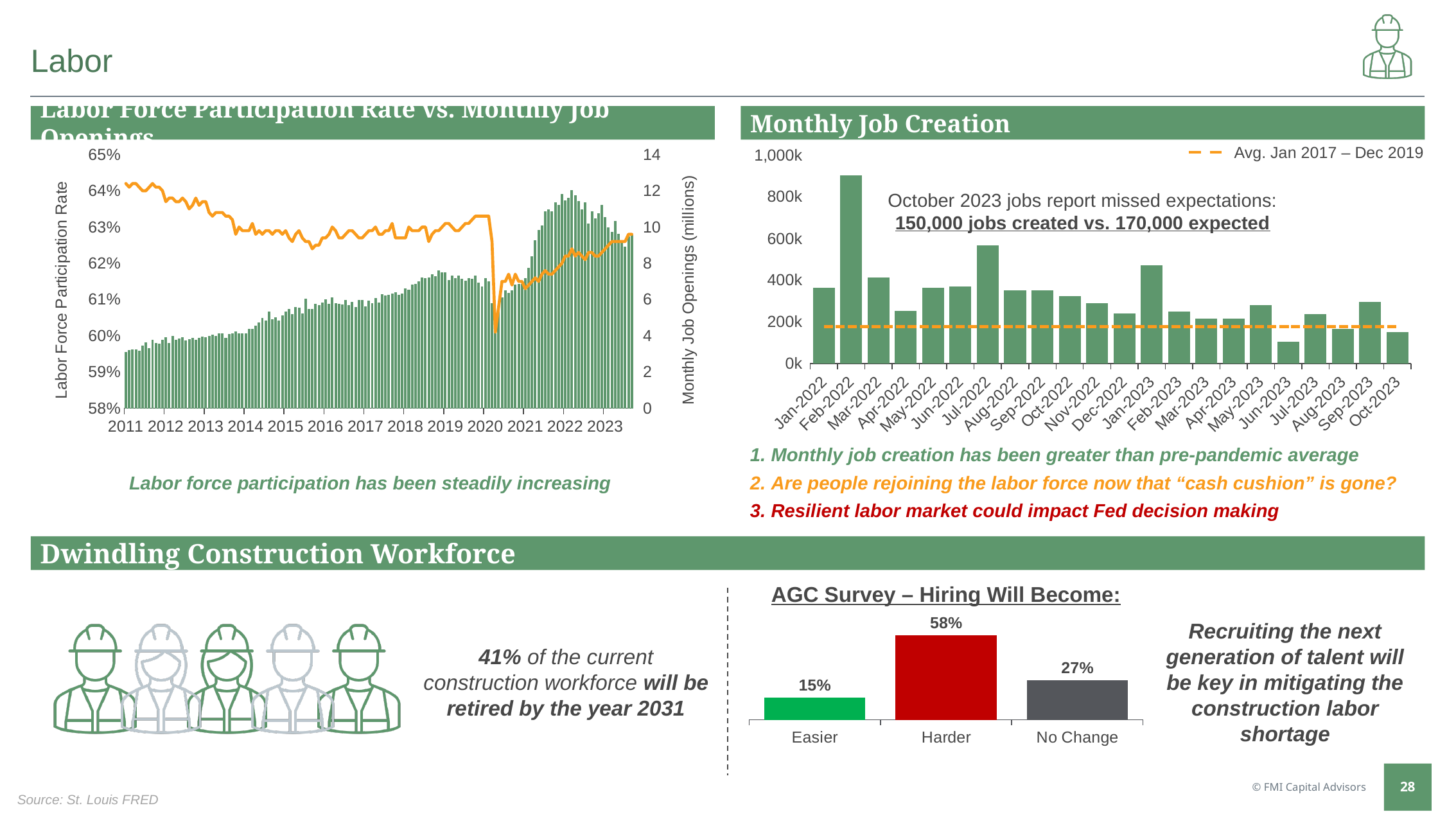
In the Monthly Job Creation chart, which is larger: the value for Jul-2022 or the value for Jan-2023? Jul-2022 In the Monthly Job Creation chart, which month has the highest job creation? Feb-2022 In the AGC Survey – Hiring Will Become chart, what percentage of respondents said hiring will become harder? 58% How many response categories are shown in the AGC Survey – Hiring Will Become chart? 3 In the Monthly Job Creation chart, which month has the lowest job creation? Jun-2023 In the AGC Survey – Hiring Will Become chart, what is the difference in percentage points between Harder and No Change? 31 In the AGC Survey – Hiring Will Become chart, which response has the lowest percentage? Easier In the Monthly Job Creation chart, what period does the dashed orange line represent according to the legend? Avg. Jan 2017 – Dec 2019 In the Monthly Job Creation chart, is the value for Jul-2022 greater or less than 400k? greater In the AGC Survey – Hiring Will Become chart, what percentage said hiring will become easier? 15% In the Monthly Job Creation chart, is the value for Oct-2023 greater or less than 200k? less